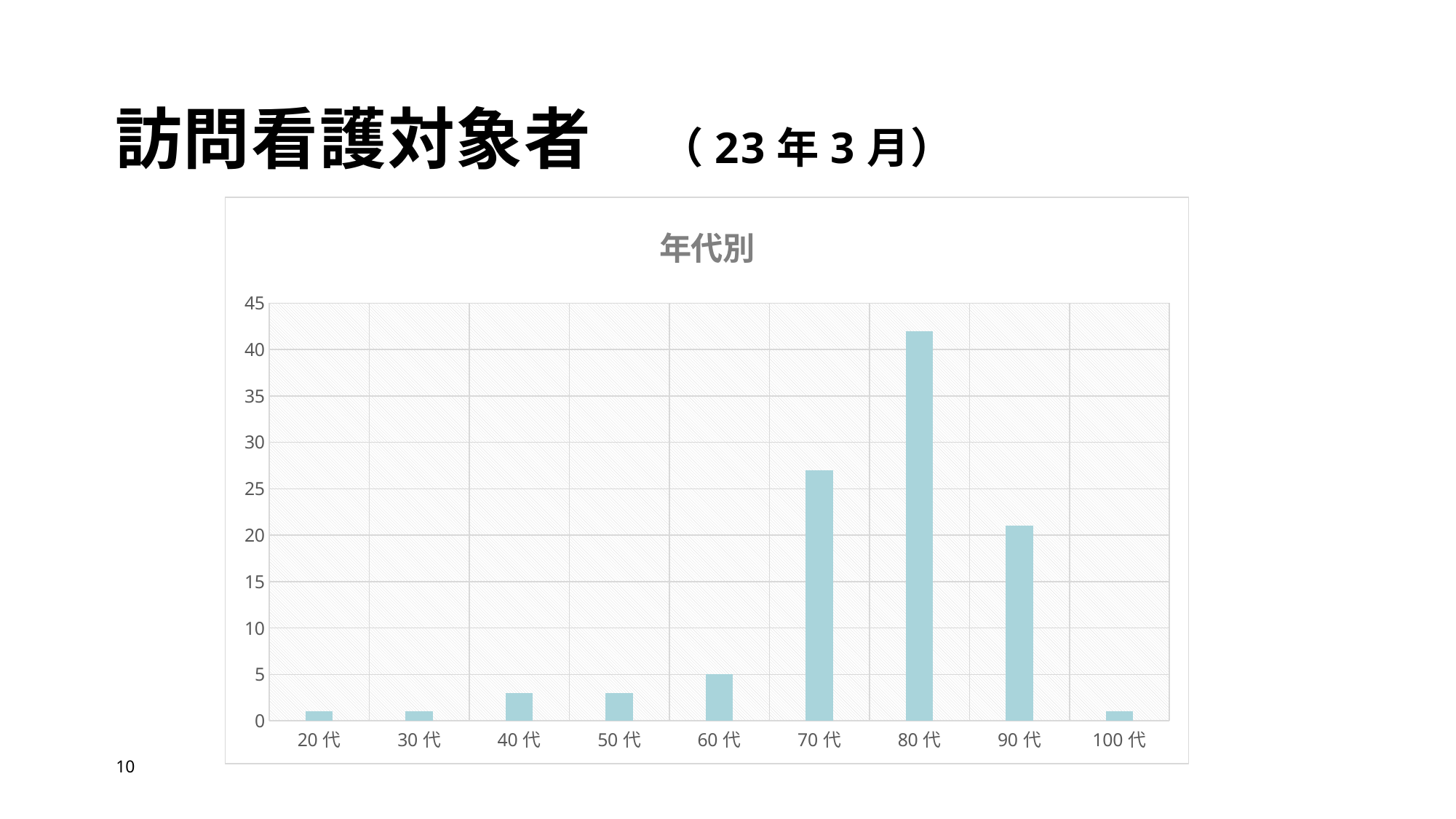
Is the value for 100代 greater or less than 5? less Which has a larger value, 70代 or 90代? 70代 Do the values rise or fall from 60代 to 80代? rise Is the value for 40代 greater or less than 5? less How many age categories are shown on the x axis of the chart? 9 Is the value for 80代 greater or less than 40? greater Which age category has the highest value in the chart? 80代 What is the value for 60代? 5 What is the title of the chart? 年代別 What kind of chart is shown on the slide? bar chart